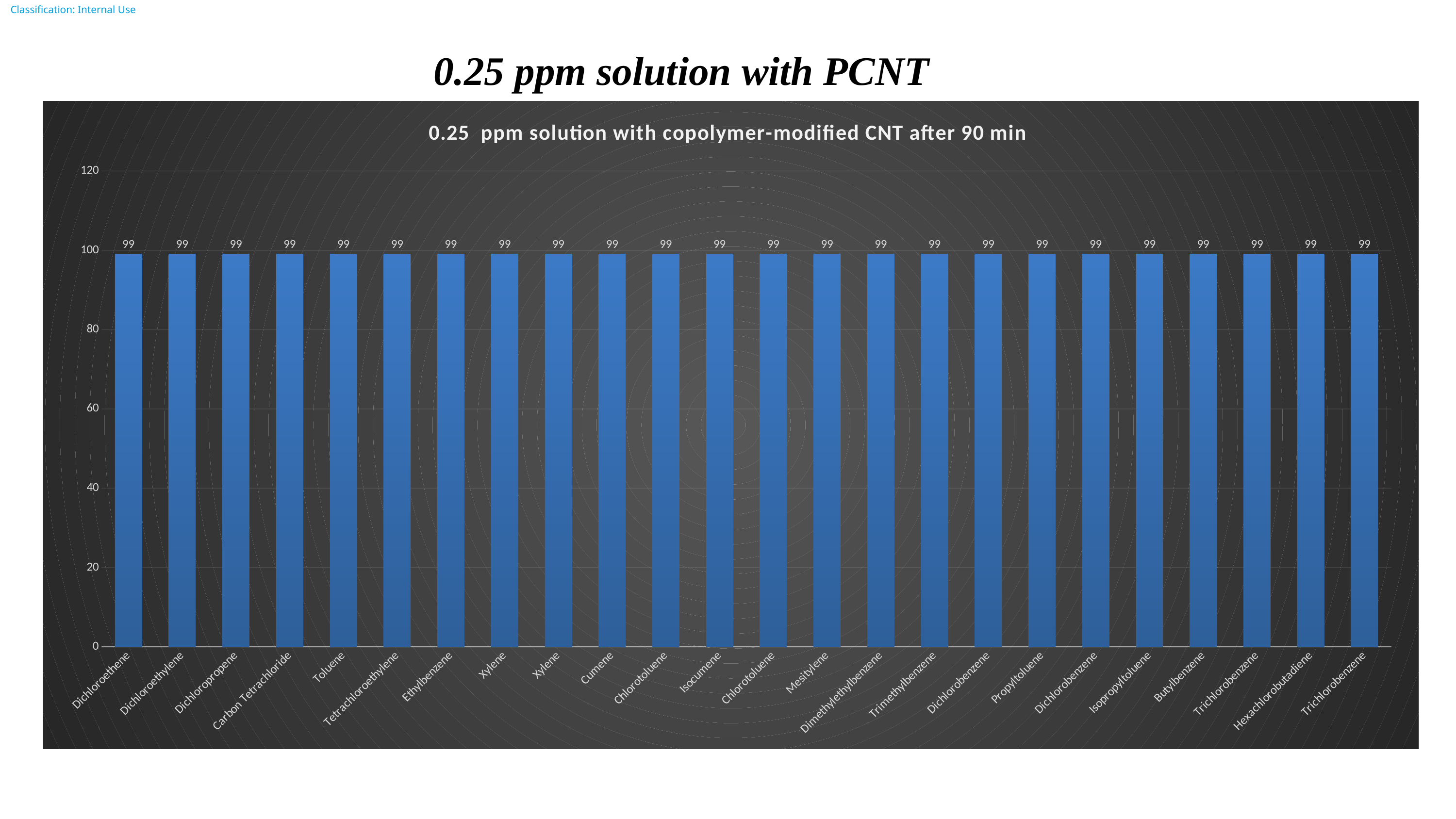
Do the values rise, fall, or stay the same across the categories along the x axis? stay the same Is the value for Propyltoluene greater or less than 120? less How many bars are plotted in the chart? 24 What colour are the bars in the chart? blue Is the value for Ethylbenzene greater or less than 80? greater What is the difference between the values for Cumene and Butylbenzene? 0 What kind of chart is shown on the slide? bar chart What is the value for Carbon Tetrachloride? 99 What is the title of the chart? 0.25 ppm solution with copolymer-modified CNT after 90 min What is the value for Toluene? 99 What is the value for Mesitylene? 99 What is the value for Hexachlorobutadiene? 99